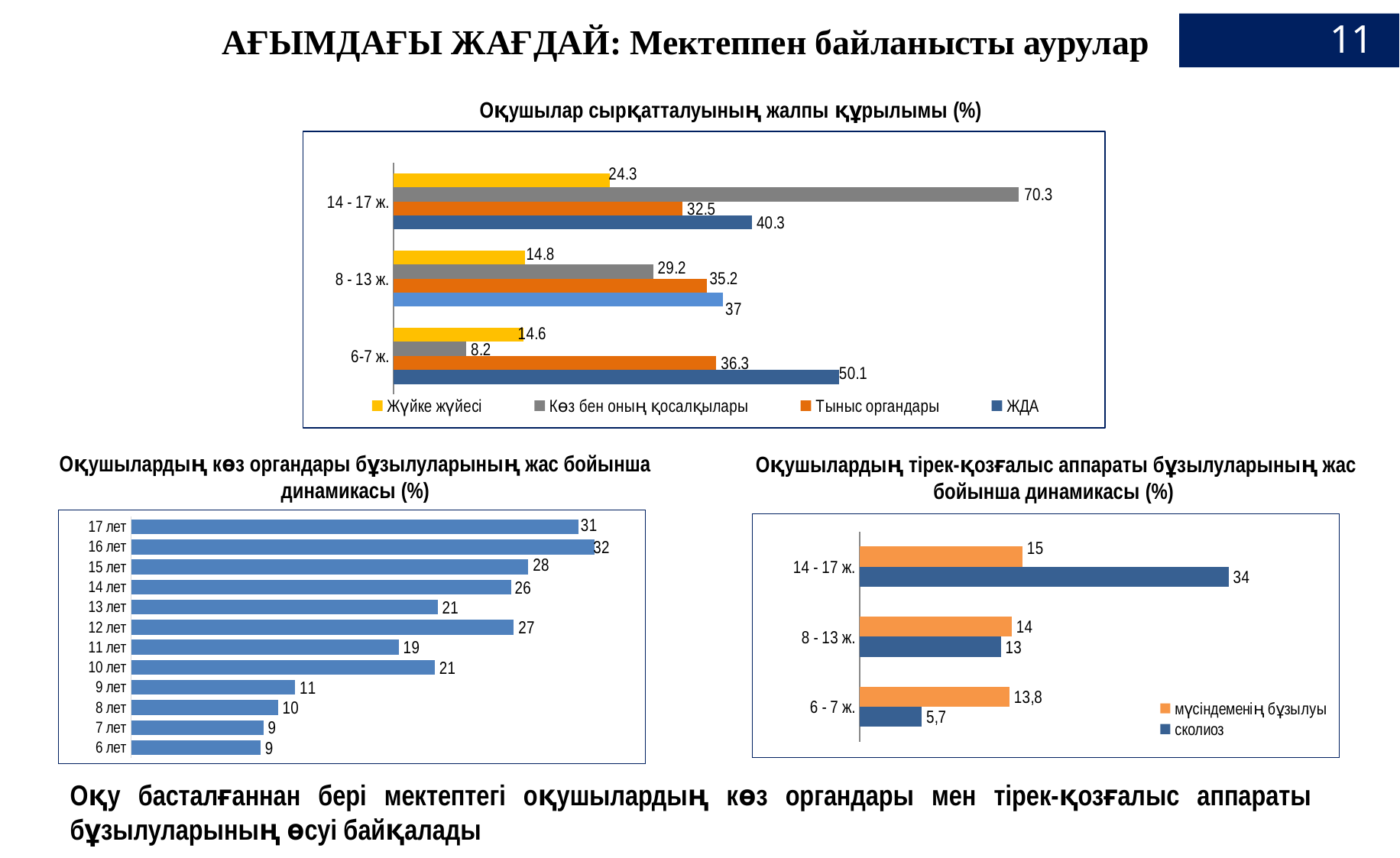
In the chart 'Оқушылардың көз органдары бұзылуларының жас бойынша динамикасы (%)', what kind of chart is it? Bar chart In the chart 'Оқушылардың көз органдары бұзылуларының жас бойынша динамикасы (%)', how many age categories are shown? 12 In the chart 'Оқушылар сырқатталуының жалпы құрылымы (%)', which age group has the lowest value for Көз бен оның қосалқылары? 6-7 ж. In the chart 'Оқушылар сырқатталуының жалпы құрылымы (%)', what is the value for ЖДА in the 6-7 ж. group? 50.1 In the chart 'Оқушылар сырқатталуының жалпы құрылымы (%)', what is the difference between the Тыныс органдары values for 6-7 ж. and 14 - 17 ж.? 3.8 In the chart 'Оқушылар сырқатталуының жалпы құрылымы (%)', what is the value for Көз бен оның қосалқылары in the 14 - 17 ж. group? 70.3 In the chart 'Оқушылардың тірек-қозғалыс аппараты бұзылуларының жас бойынша динамикасы (%)', which is larger for 6 - 7 ж.: мүсіндеменің бұзылуы or сколиоз? мүсіндеменің бұзылуы In the chart 'Оқушылардың тірек-қозғалыс аппараты бұзылуларының жас бойынша динамикасы (%)', what is the value for сколиоз in the 14 - 17 ж. group? 34 In the chart 'Оқушылар сырқатталуының жалпы құрылымы (%)', how many series does the legend list? 4 In the chart 'Оқушылардың тірек-қозғалыс аппараты бұзылуларының жас бойынша динамикасы (%)', what is the difference between сколиоз for 14 - 17 ж. and 8 - 13 ж.? 21 In the chart 'Оқушылардың көз органдары бұзылуларының жас бойынша динамикасы (%)', what is the value for 12 лет? 27 In the chart 'Оқушылардың көз органдары бұзылуларының жас бойынша динамикасы (%)', which age has the highest value? 16 лет